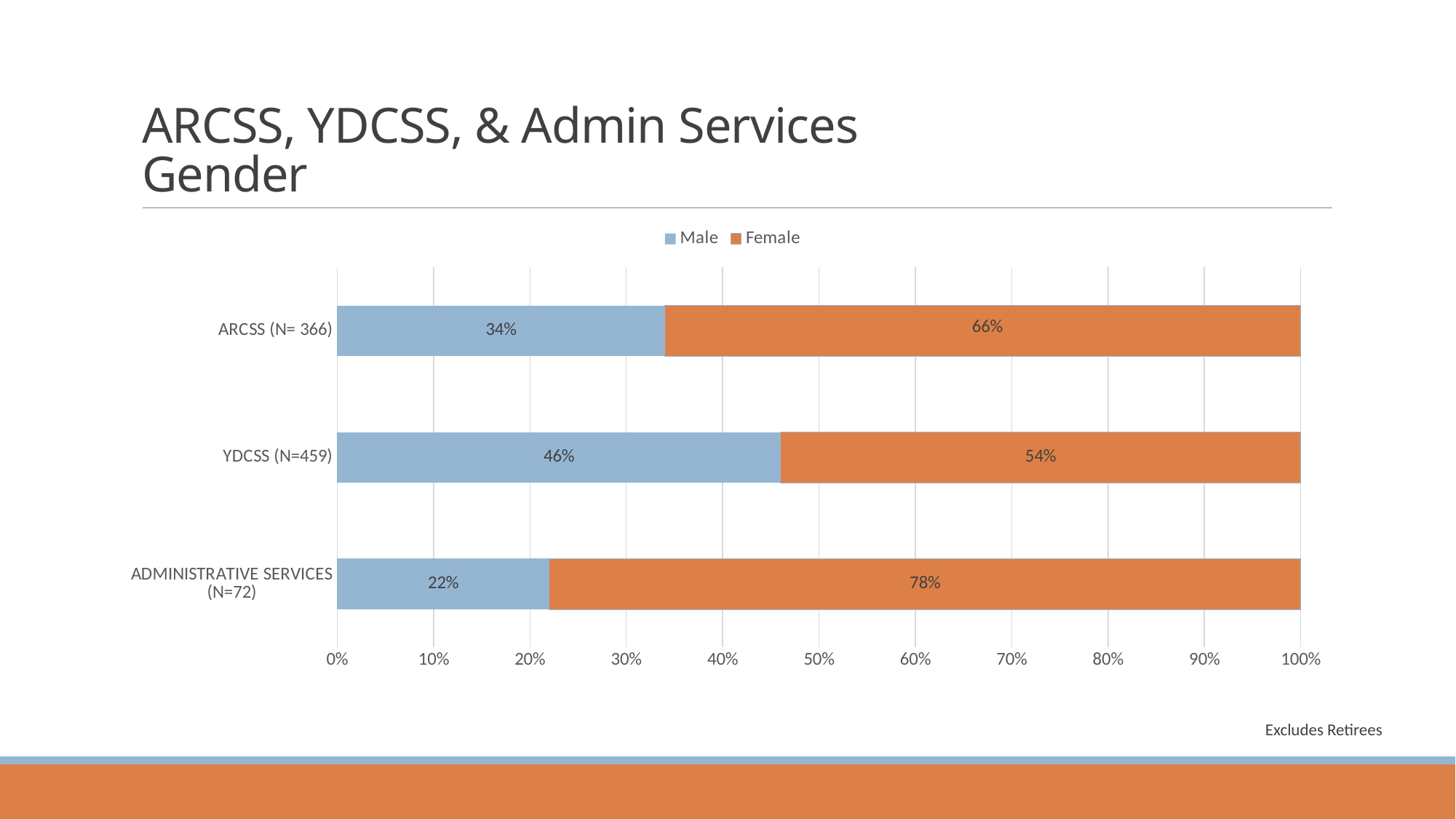
Which category has the lowest Male percentage? ADMINISTRATIVE SERVICES (N=72) What is the difference between the Female and Male percentages for YDCSS (N=459)? 8% Is the Male percentage larger for ARCSS (N= 366) or for YDCSS (N=459)? YDCSS (N=459) Which category has the highest Female percentage? ADMINISTRATIVE SERVICES (N=72) How many series does the legend list? 2 What kind of chart is shown on the slide? Stacked bar chart What percentage of ADMINISTRATIVE SERVICES (N=72) is Male? 22% How many categories are shown on the chart? 3 What percentage of YDCSS (N=459) is Female? 54% What is the total of the stacked bar for ARCSS (N= 366)? 100% Which colour represents the Female series? Orange What percentage of ARCSS (N= 366) is Male? 34%